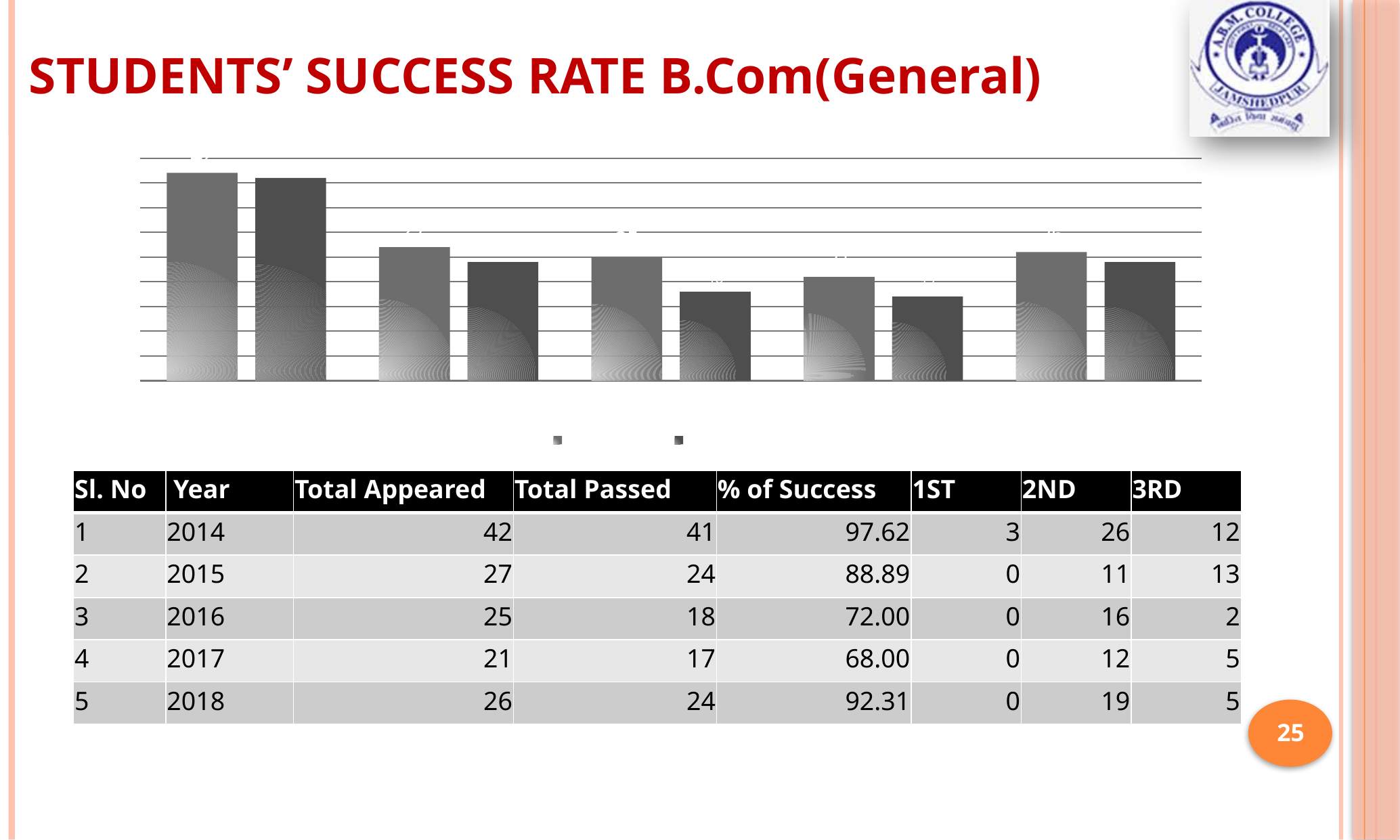
Do the darker bars rise or fall from the fourth group to the fifth group? rise Is the darker bar in the second group taller or shorter than the darker bar in the third group? taller What colours are used for the two series in the chart? light grey and dark grey Which group of bars, counted from the left, has the shortest bars? the fourth group In the first group of bars from the left, is the lighter bar or the darker bar taller? the lighter bar What kind of chart is shown on the slide? bar chart How many series does the chart's legend list? 2 Which group of bars, counted from the left, has the tallest bars? the first group How many groups of bars does the chart show? 5 Do the lighter bars rise or fall from the first group to the fourth group? fall In each group, is the lighter bar taller or shorter than the darker bar? taller How many bars are plotted in the chart in total? 10